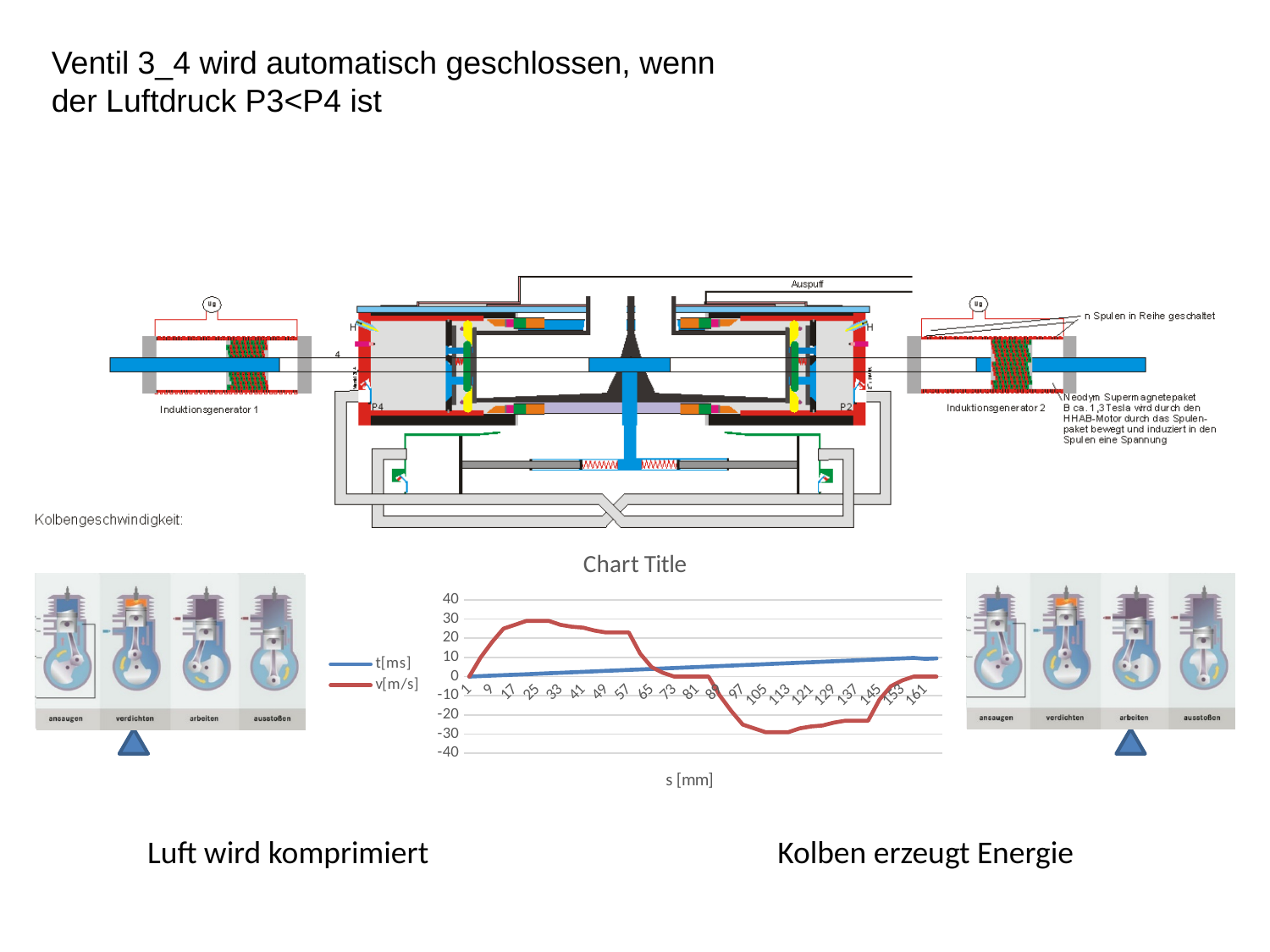
How many series does the chart legend list? 2 What kind of chart is shown on the slide? line chart Is the value of v[m/s] at s = 57 greater or less than 10? greater Which is larger, v[m/s] at s = 57 or v[m/s] at s = 81? s = 57 What are the two series named in the chart legend? t[ms] and v[m/s] What is the label of the x axis of the chart? s [mm] Is the value of v[m/s] at s = 25 greater or less than 20? greater Is the value of v[m/s] at s = 105 greater or less than -20? less Which is larger, v[m/s] at s = 25 or v[m/s] at s = 105? s = 25 Does the t[ms] series rise or fall along the x axis? rise Does the v[m/s] series rise or fall between s = 57 and s = 105? fall